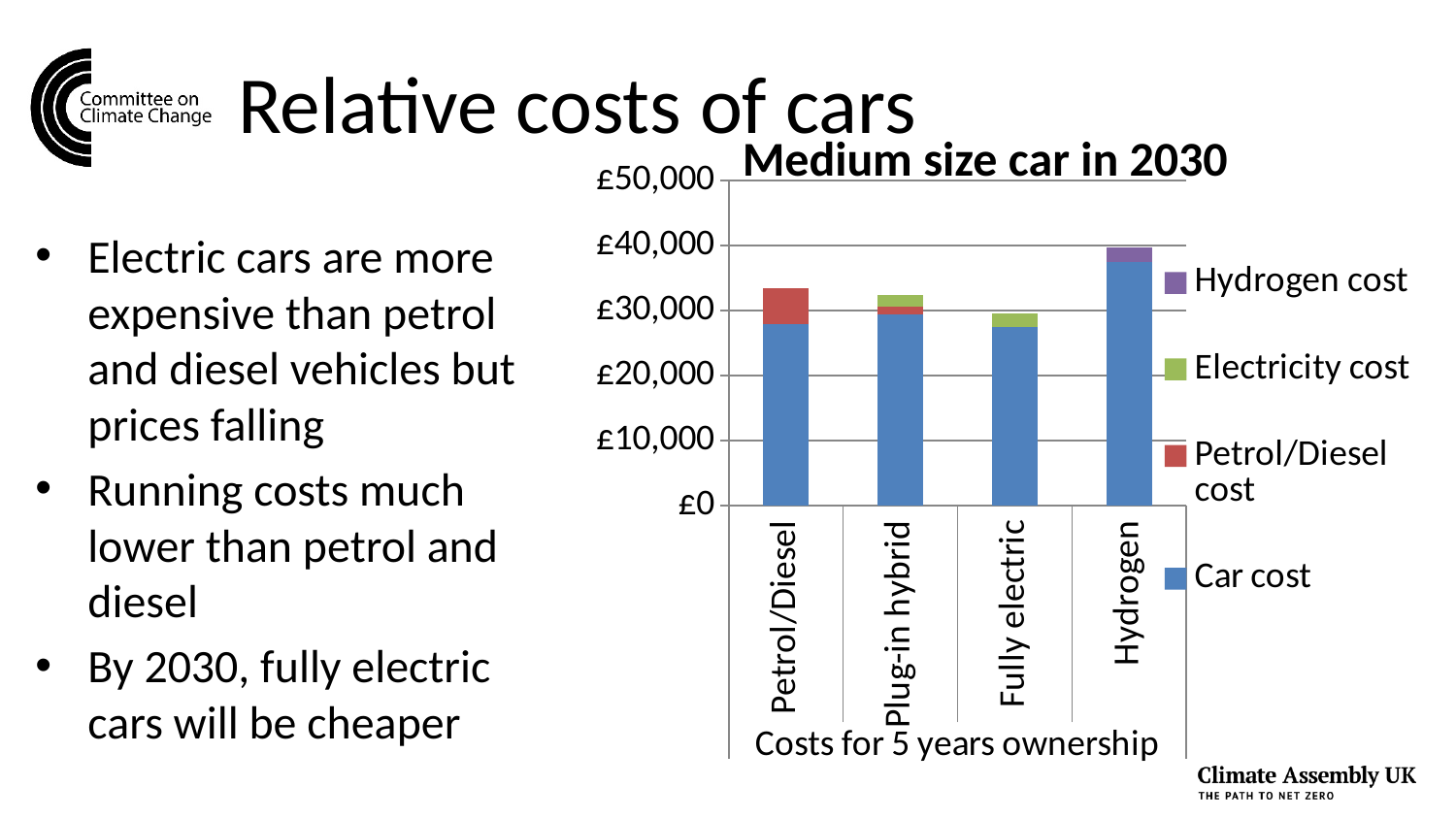
Which car type has the highest total cost for 5 years ownership? Hydrogen Which has a larger total cost, Hydrogen or Plug-in hybrid? Hydrogen What is the title of the chart? Medium size car in 2030 Is the total cost for Fully electric greater or less than £40,000? less Is the total cost for Petrol/Diesel greater or less than £30,000? greater What is the label on the x axis of the chart? Costs for 5 years ownership Is the total cost for Hydrogen greater or less than £30,000? greater What kind of chart is shown on the slide? Stacked bar chart How many series does the chart's legend list? 4 How many car types (categories) are shown on the x axis of the chart? 4 Which car type has the lowest total cost for 5 years ownership? Fully electric Which has a larger total cost, Petrol/Diesel or Fully electric? Petrol/Diesel